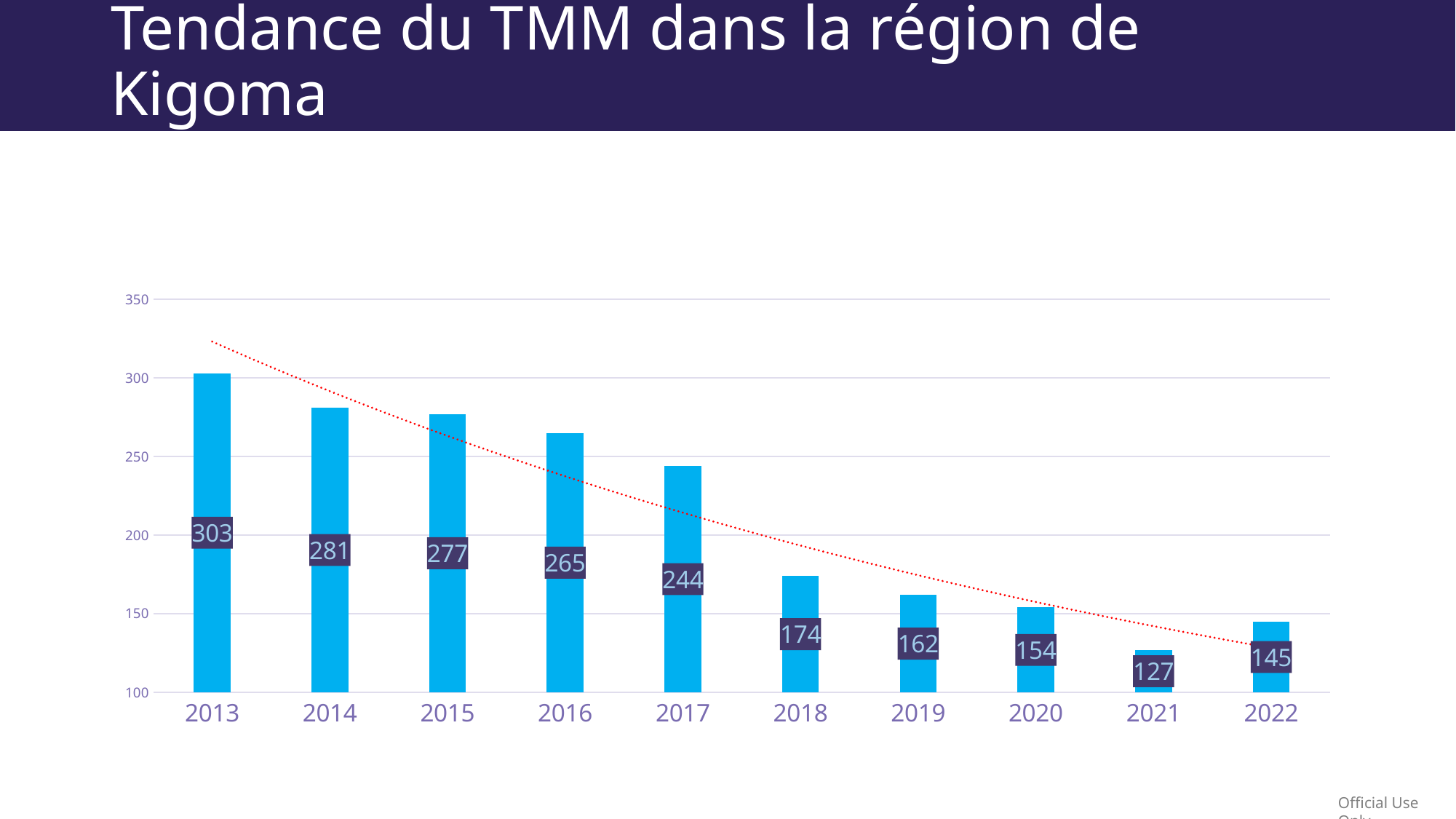
Is the value for 2016 greater or less than 250? less What is the value for 2022? 145 What is the value for 2018? 174 Which year has the lowest value? 2021 What kind of chart is shown on the slide? bar chart How many years are shown on the x axis? 10 What is the difference between the values for 2013 and 2022? 158 Which is larger, the value for 2021 or the value for 2022? 2022 Which year has the highest value? 2013 What is the value for 2013? 303 What is the difference between the values for 2017 and 2018? 70 Do the values generally rise or fall from 2013 to 2022? fall